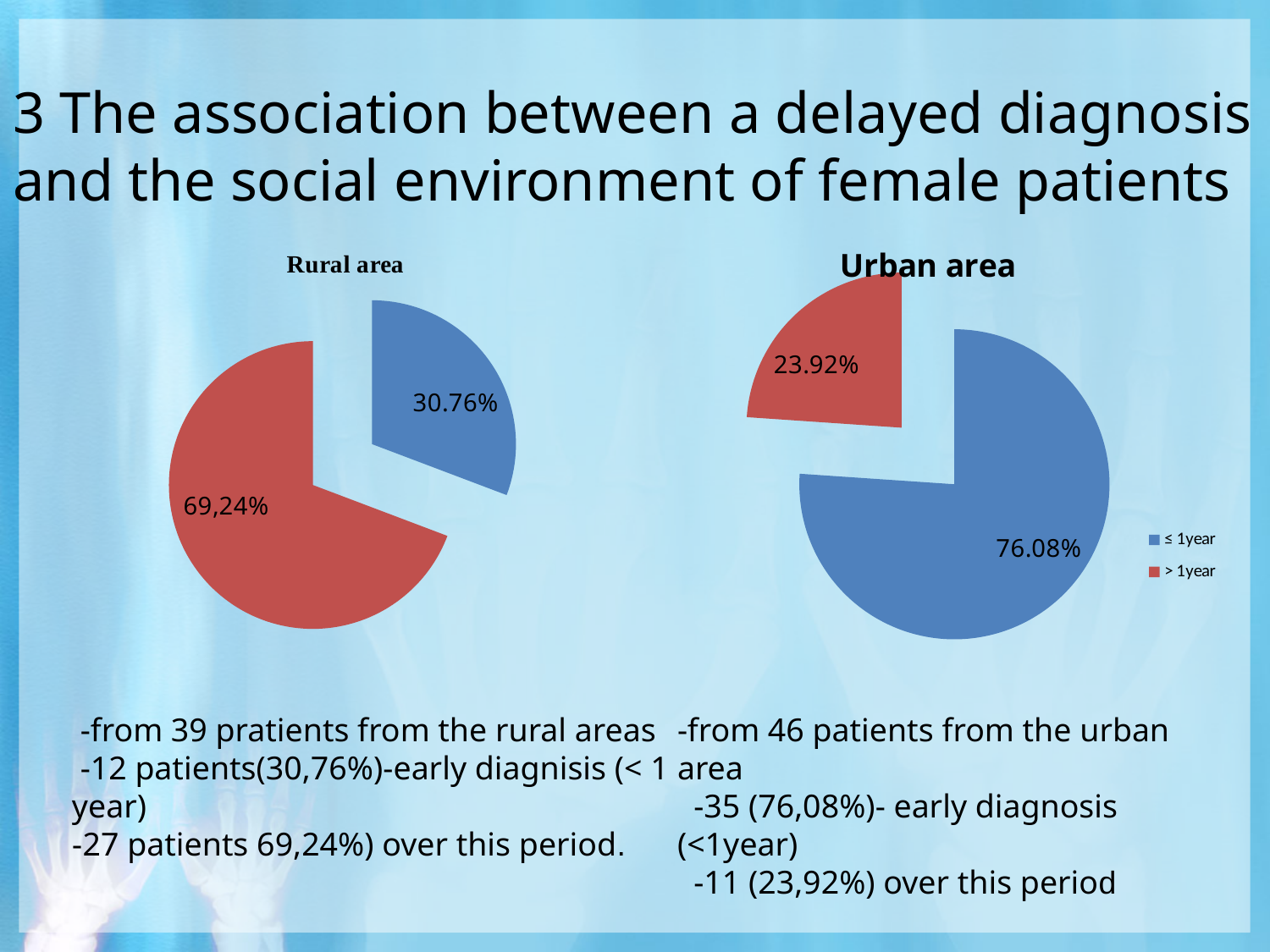
What colour represents the "> 1year" category in the charts? red In the "Rural area" chart, what percentage is shown for the "> 1year" slice? 69,24% How many slices does the "Rural area" pie chart have? 2 In the "Rural area" chart, which slice is the largest? > 1year In the "Rural area" chart, what percentage is shown for the "≤ 1year" slice? 30.76% What kind of chart is the "Rural area" chart? pie chart What is the title of the pie chart on the right? Urban area In the "Urban area" chart, what percentage is shown for the "> 1year" slice? 23.92% In the "Urban area" chart, which slice is the smallest? > 1year In the "Urban area" chart, what percentage is shown for the "≤ 1year" slice? 76.08% In the "Urban area" chart, which slice is larger, "≤ 1year" or "> 1year"? ≤ 1year How many entries does the legend list? 2